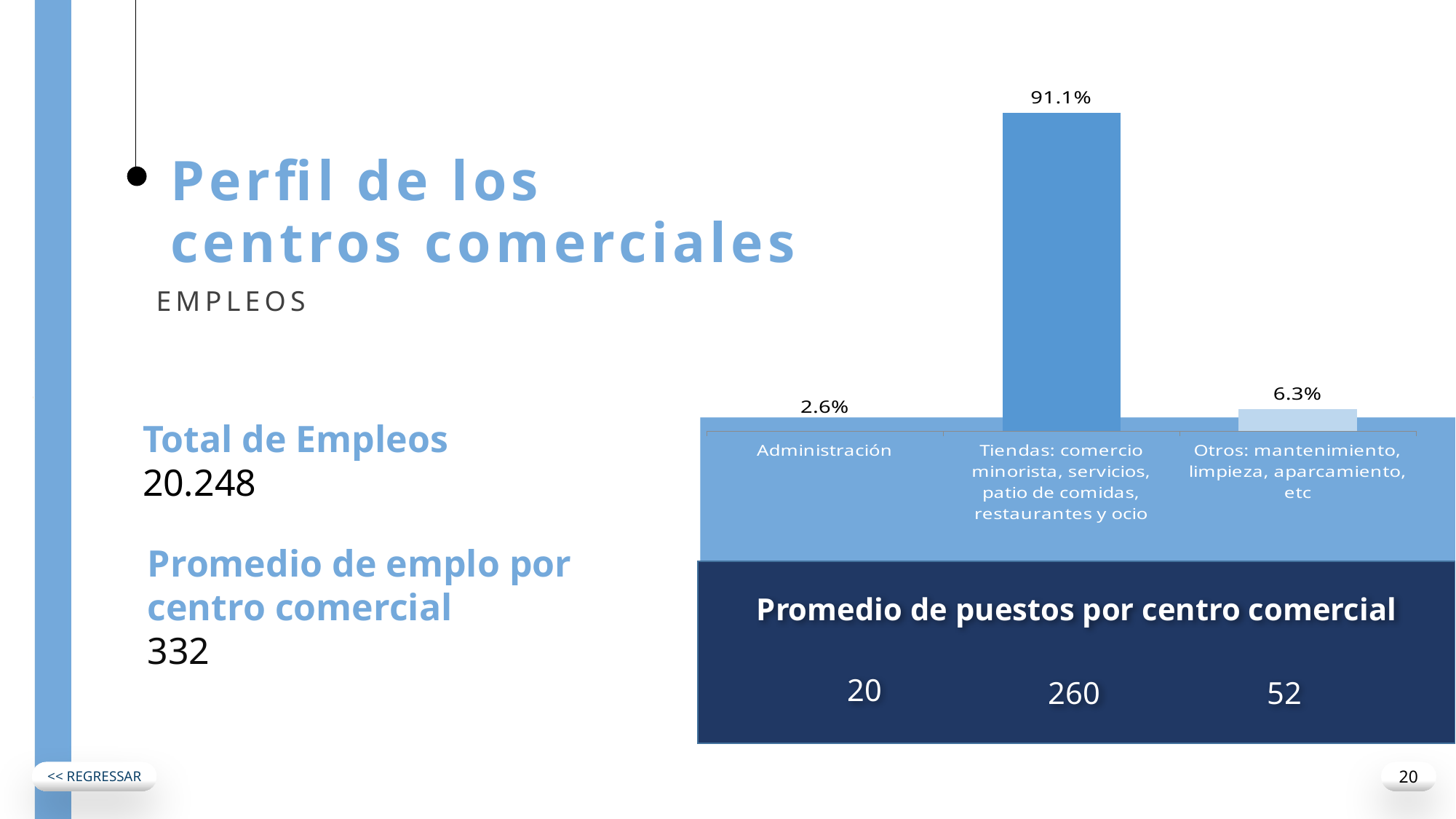
What is the value for Tiendas: comercio minorista, servicios, patio de comidas, restaurantes y ocio in the bar chart? 91.1% What is the total of the three percentages shown in the bar chart? 100% How many categories are shown in the bar chart? 3 Which category has the lowest value in the bar chart? Administración Which category has the highest value in the bar chart? Tiendas: comercio minorista, servicios, patio de comidas, restaurantes y ocio What is the difference between the values for Otros and Administración in the bar chart? 3.7% What kind of chart is shown on the slide? Bar chart What is the value for Administración in the bar chart? 2.6% What is the difference between the values for Tiendas and Otros in the bar chart? 84.8% What is the subtitle shown under the slide title 'Perfil de los centros comerciales'? EMPLEOS What is the value for Otros: mantenimiento, limpieza, aparcamiento, etc in the bar chart? 6.3% Which is larger in the bar chart, the value for Administración or the value for Otros? Otros